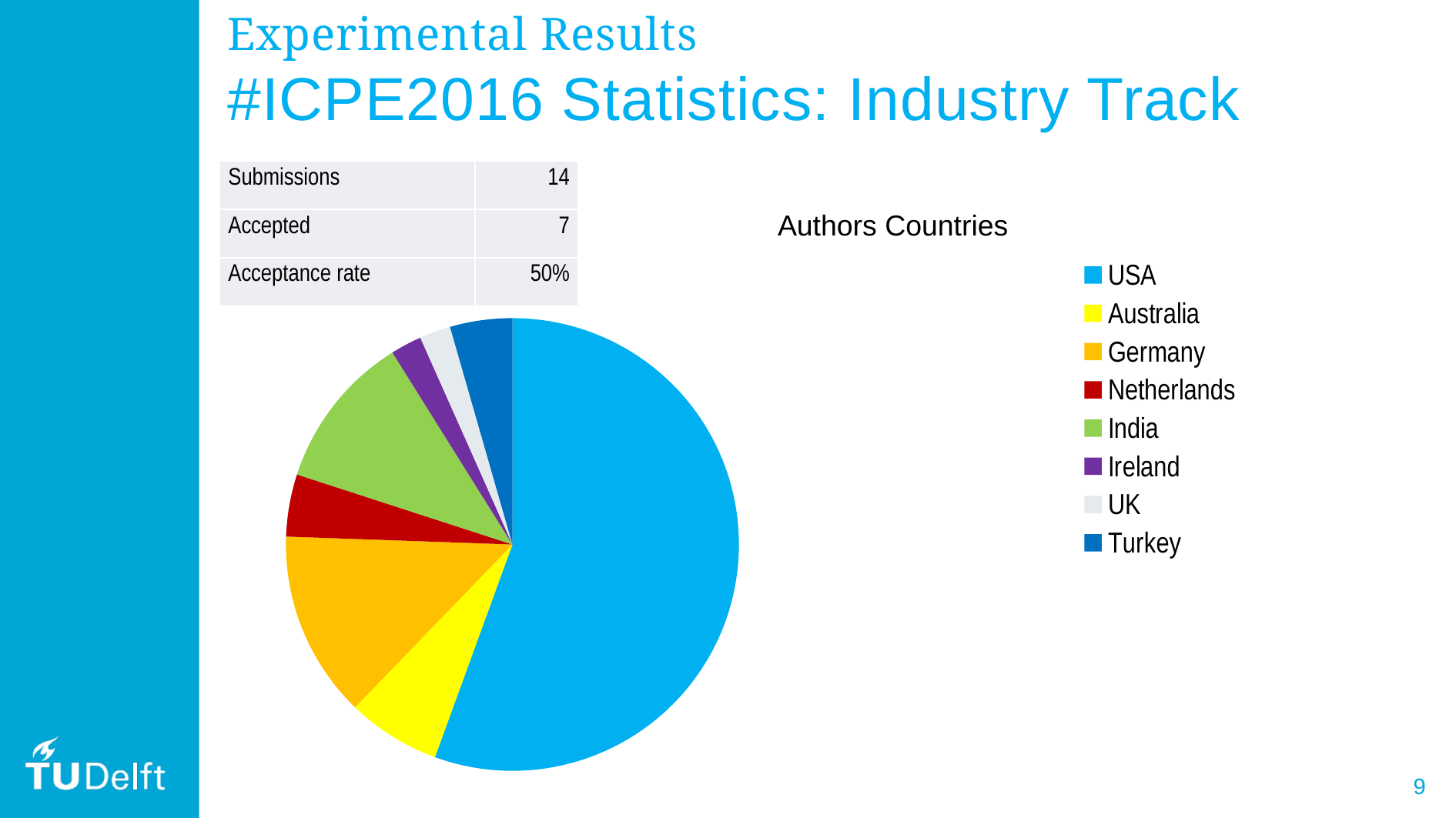
Which country has the largest slice in the Authors Countries pie chart? USA In the Authors Countries pie chart, which slice is larger, India or Ireland? India In the Authors Countries pie chart, which slice is larger, Germany or Australia? Germany What is the title of the pie chart on the slide? Authors Countries In the Authors Countries pie chart, which slice is larger, USA or Germany? USA What kind of chart is shown under the heading "Authors Countries"? pie chart Which country is shown in yellow in the Authors Countries pie chart? Australia How many countries does the legend of the Authors Countries pie chart list? 8